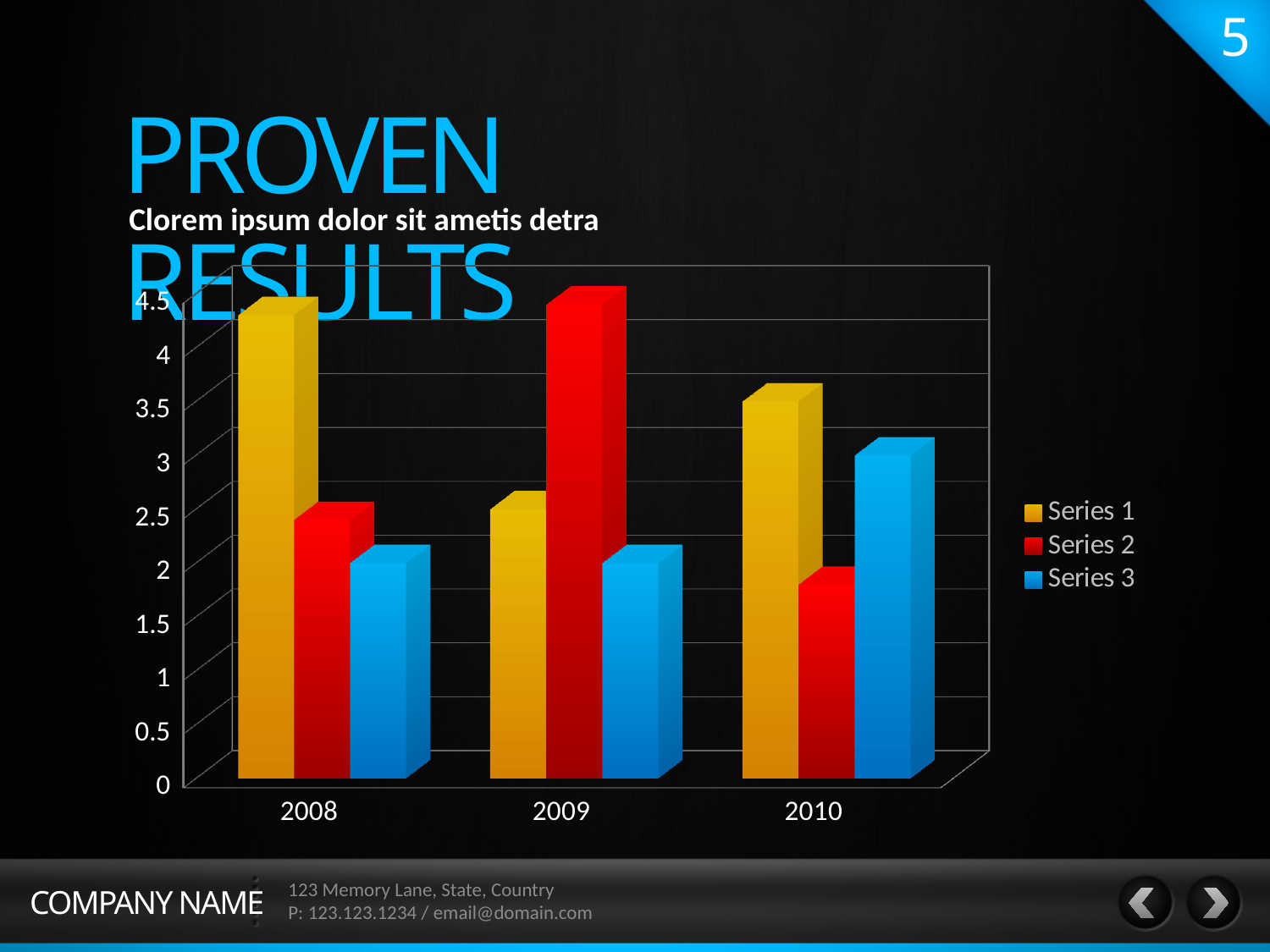
Does Series 2 rise or fall from 2008 to 2009? rise In 2009, which is larger: Series 2 or Series 3? Series 2 In which year is Series 3 highest? 2010 In which year is Series 2 lowest? 2010 Is the value for Series 1 in 2009 greater or less than 3? less What kind of chart is shown on the slide? bar chart How many categories are shown on the x axis? 3 How many series does the legend list? 3 In which year is Series 1 highest? 2008 Is the value for Series 3 in 2010 greater or less than 2.5? greater In which year is Series 2 highest? 2009 Is the value for Series 1 in 2008 greater or less than 4? greater